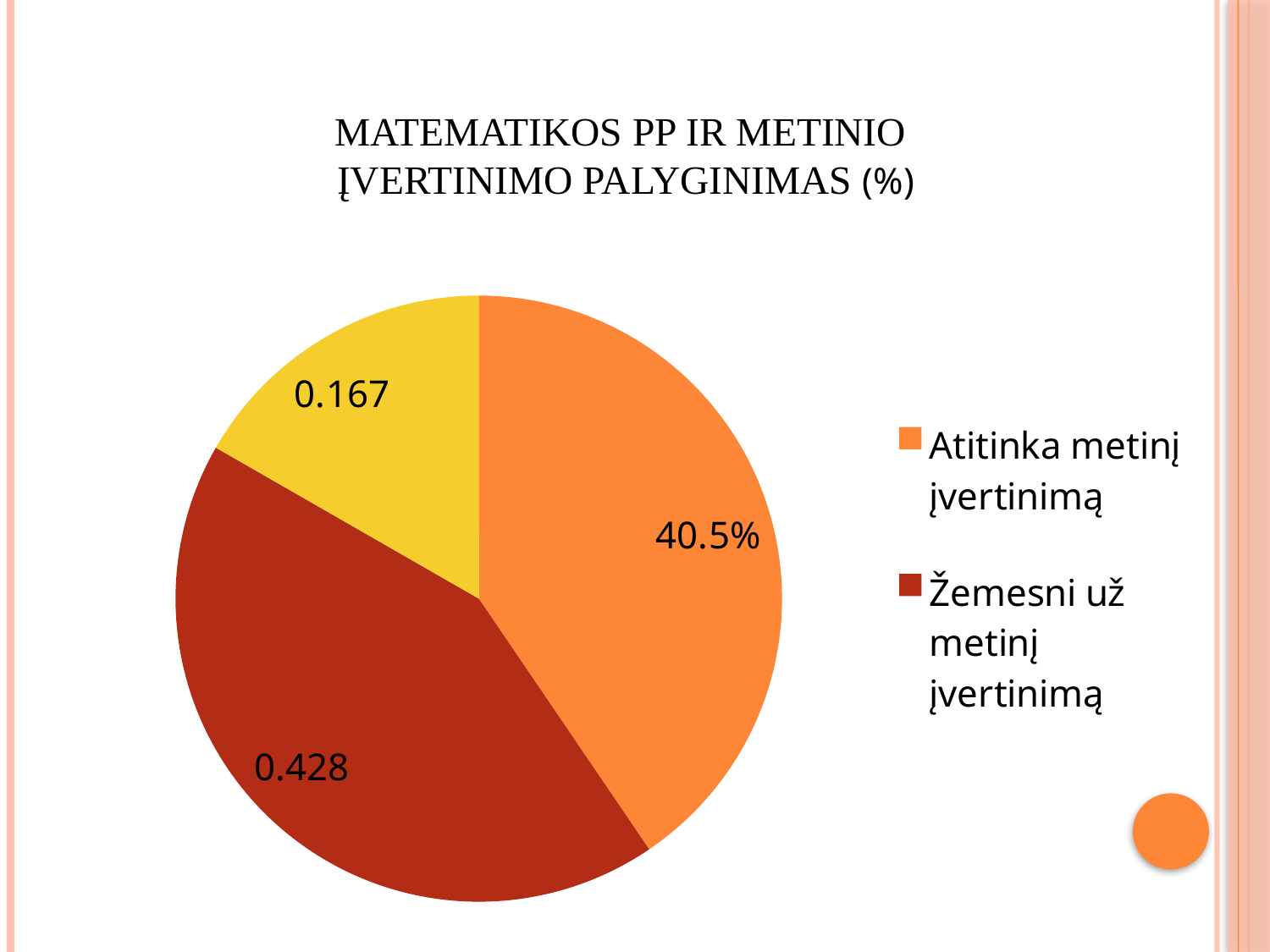
What is the title of the chart? MATEMATIKOS PP IR METINIO ĮVERTINIMO PALYGINIMAS (%) What value is printed on the smallest slice of the pie? 0.167 How many entries does the legend list? 2 Is the slice labelled 0.428 larger or smaller than the slice labelled 0.167? larger What kind of chart is shown on the slide? pie chart How many slices does the pie chart have? 3 What is the difference between the value labelled 0.428 and the value labelled 0.167? 0.261 What colour is the "Žemesni už metinį įvertinimą" slice? dark red What is the value shown for the "Atitinka metinį įvertinimą" slice? 40.5% What is the value shown for the "Žemesni už metinį įvertinimą" slice? 0.428